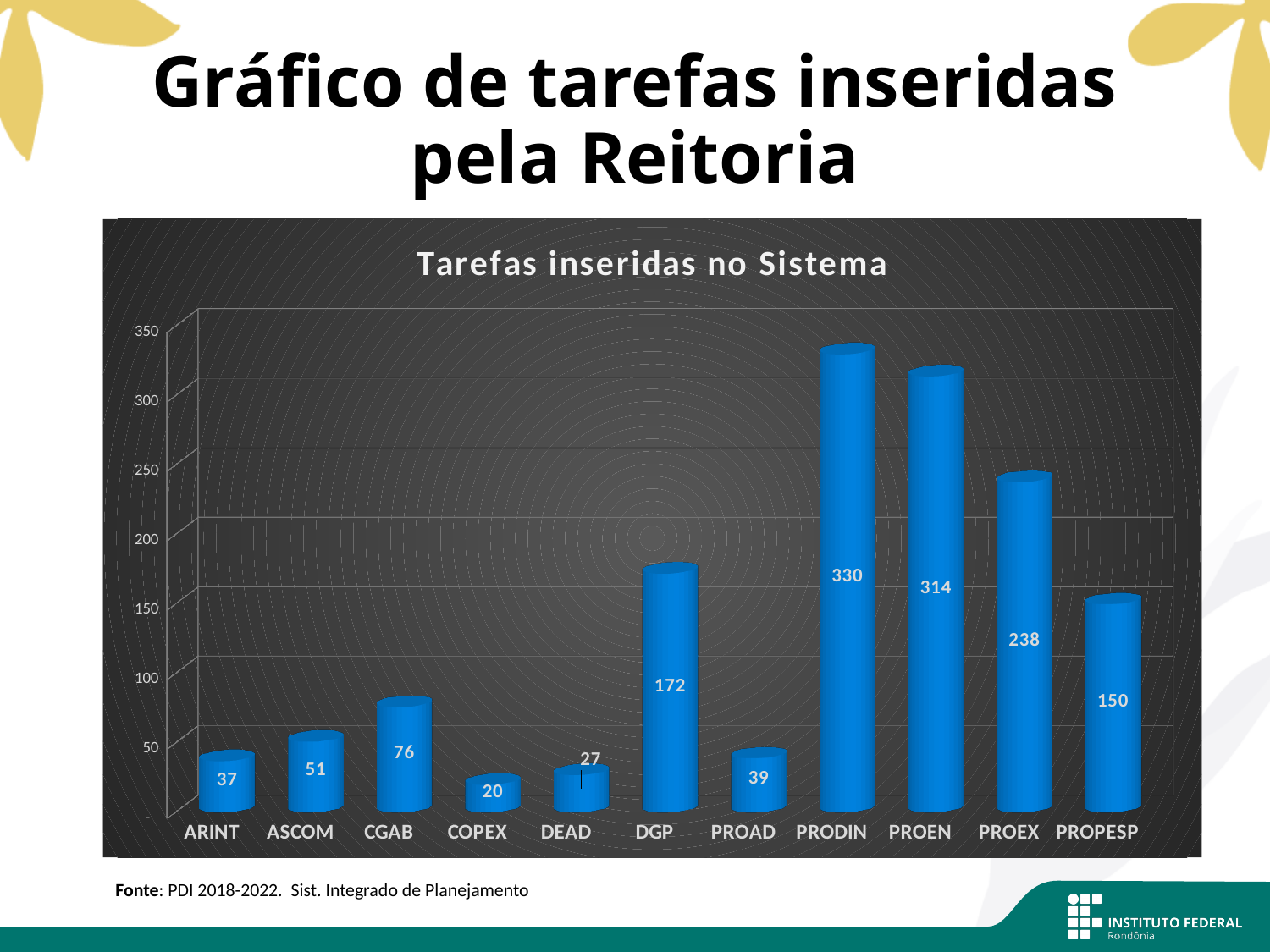
How many categories are shown on the x axis? 11 What is the difference between the values for CGAB and ASCOM? 25 What is the difference between the values for PRODIN and PROEN? 16 What kind of chart is this? bar chart Is the value for PROEN greater or less than 300? greater Which category has the highest value? PRODIN Which is larger, the value for PROEX or the value for PROPESP? PROEX What is the value for DGP? 172 What is the value for PRODIN? 330 What is the title of the chart? Tarefas inseridas no Sistema Which category has the lowest value? COPEX What is the value for COPEX? 20